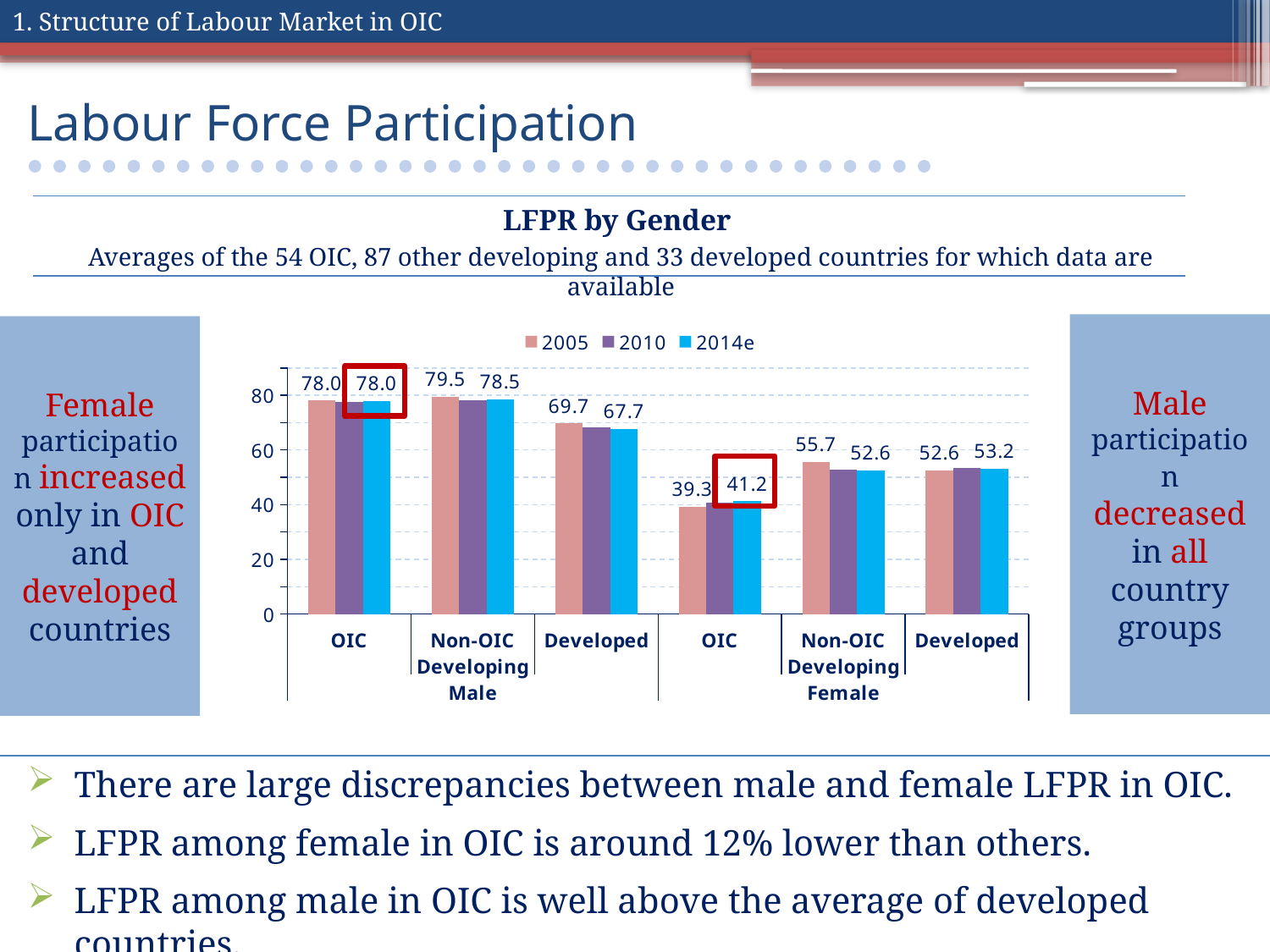
What are the series listed in the legend of the LFPR by Gender chart? 2005, 2010, 2014e How many series does the legend of the LFPR by Gender chart list? 3 What type of chart is shown on the slide? bar chart Which category has the highest 2005 value in the LFPR by Gender chart? Non-OIC Developing Male What is the 2005 value for Developed Male in the LFPR by Gender chart? 69.7 What is the 2005 value for Non-OIC Developing Male in the LFPR by Gender chart? 79.5 Is the 2014e value for Developed Male larger or smaller than the 2005 value for Developed Male in the LFPR by Gender chart? smaller Which category has the lowest 2005 value in the LFPR by Gender chart? OIC Female What is the 2014e value for Non-OIC Developing Female in the LFPR by Gender chart? 52.6 What is the 2014e value for OIC Female in the LFPR by Gender chart? 41.2 What is the difference between the 2014e values for OIC Male and OIC Female in the LFPR by Gender chart? 36.8